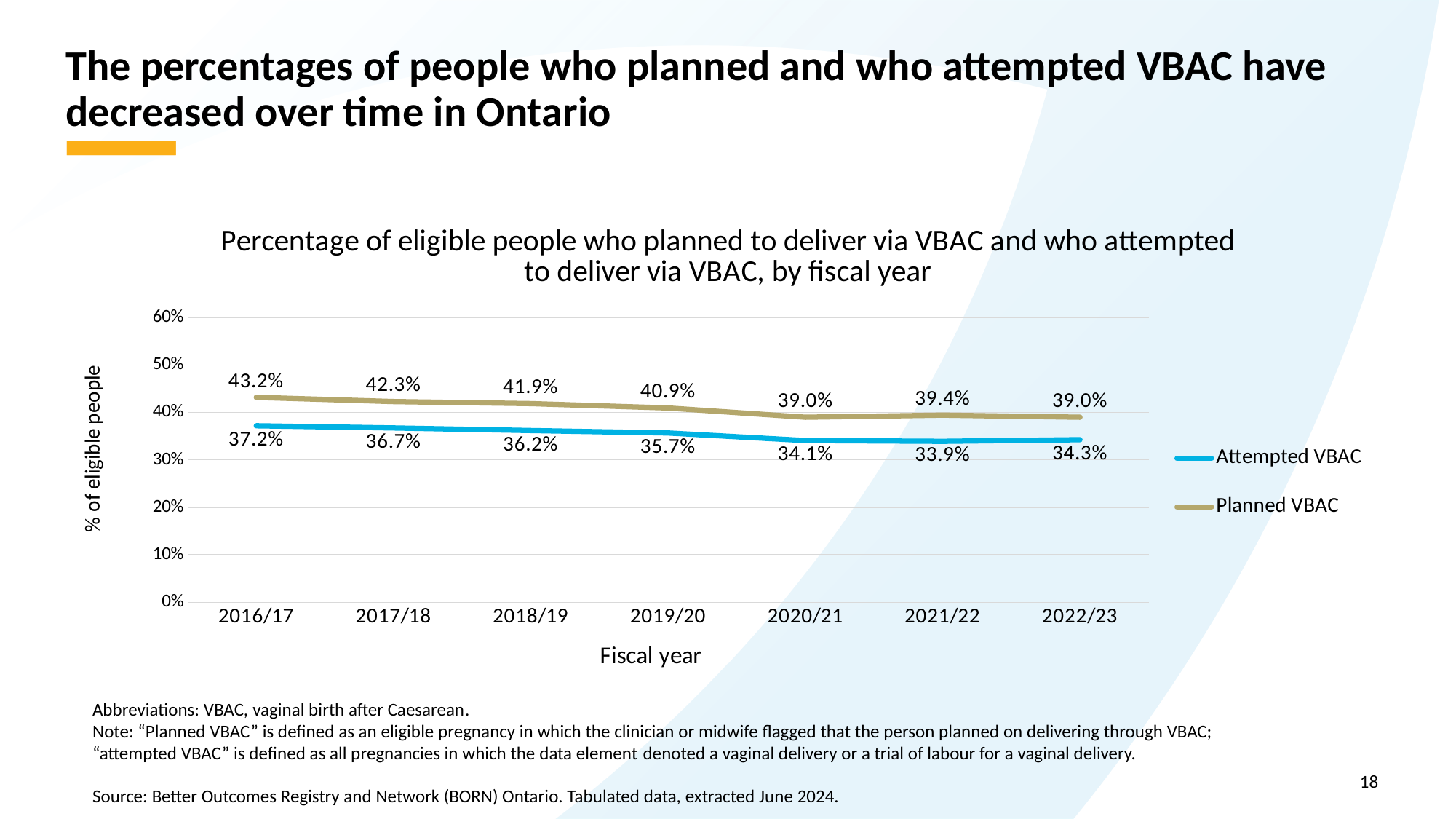
Which series has the higher value in 2018/19, Planned VBAC or Attempted VBAC? Planned VBAC What percentage of eligible people attempted VBAC in 2022/23? 34.3% In which fiscal year was the Attempted VBAC percentage lowest? 2021/22 What percentage of eligible people planned VBAC in 2016/17? 43.2% How many series does the legend list? 2 Is the Planned VBAC value for 2017/18 greater or less than 40%? greater Does the Planned VBAC percentage generally rise or fall from 2016/17 to 2022/23? Fall How many fiscal years are shown on the x axis? 7 What kind of chart is shown on the slide? Line chart What is the difference between the Planned VBAC and Attempted VBAC percentages in 2020/21? 4.9% In which fiscal year was the Planned VBAC percentage highest? 2016/17 What was the Attempted VBAC value in 2019/20? 35.7%